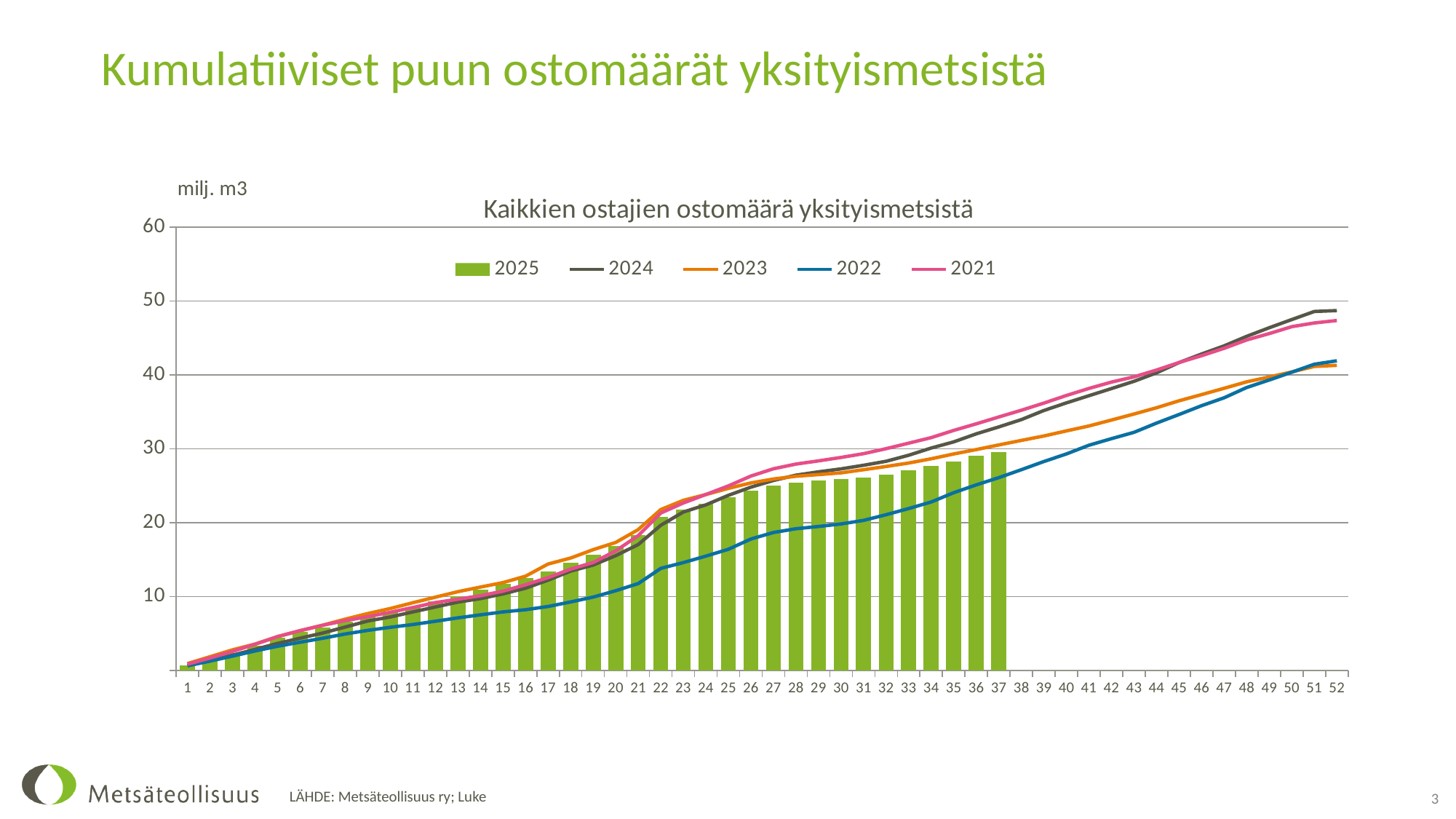
At week 40, which is larger: the 2021 line or the 2022 line? 2021 Is the value of the 2025 bar at week 37 greater or less than 20? greater What kind of chart is shown on the slide? A combined bar and line chart How many series does the chart legend list? 5 Up to which week are 2025 bars plotted? 37 Is the value of the 2022 line at week 20 greater or less than 20? less Which series has the highest value at week 52? 2024 Which series is shown as bars rather than a line? 2025 What is the title of the chart? Kaikkien ostajien ostomäärä yksityismetsistä Do the values for the 2024 line rise or fall along the x axis? Rise How many week categories are shown on the x axis? 52 Is the value of the 2024 line at week 52 greater or less than 40? greater